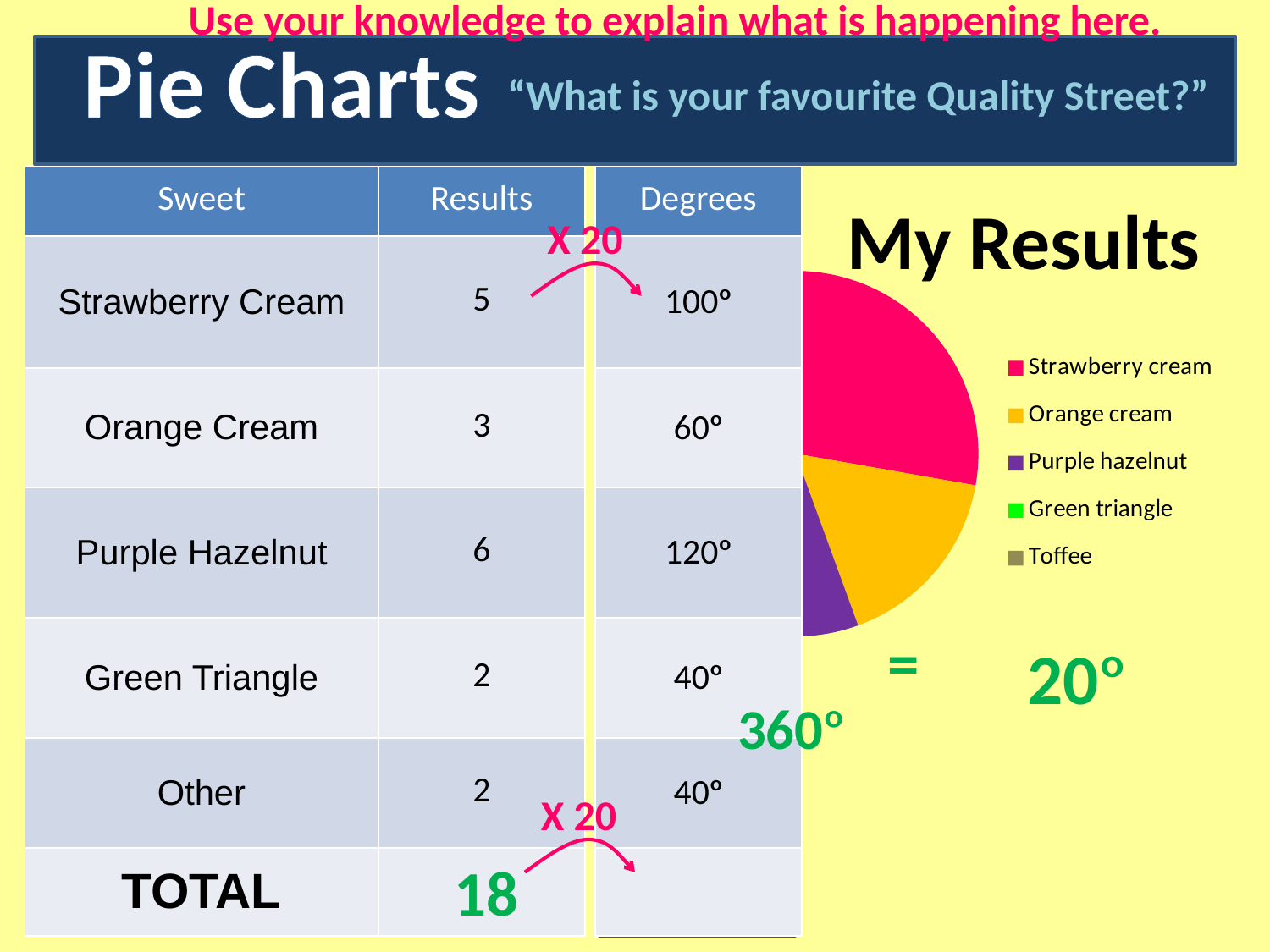
In the "My Results" pie chart, which slice is larger: Strawberry cream or Orange cream? Strawberry cream What kind of chart is shown under the title "My Results"? pie chart What is the title of the pie chart on the slide? My Results How many entries does the legend of the "My Results" pie chart list? 5 Which colour represents Orange cream in the "My Results" pie chart? orange